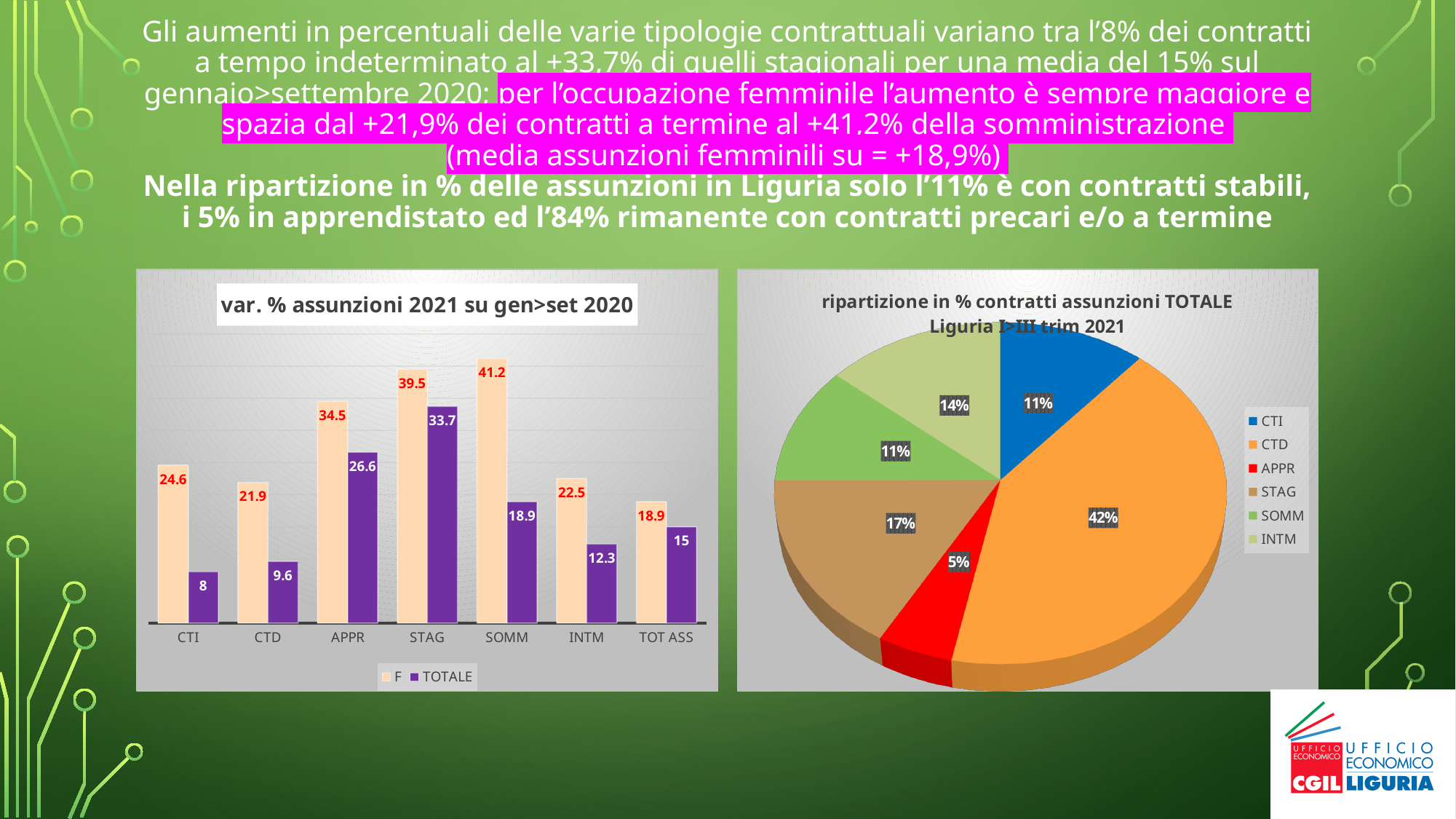
How many categories are shown on the x axis of the bar chart 'var. % assunzioni 2021 su gen>set 2020'? 7 In the bar chart 'var. % assunzioni 2021 su gen>set 2020', which category has the highest F value? SOMM In the bar chart 'var. % assunzioni 2021 su gen>set 2020', what is the F value for SOMM? 41.2 In the bar chart 'var. % assunzioni 2021 su gen>set 2020', what is the difference between the F and TOTALE values for CTI? 16.6 In the bar chart 'var. % assunzioni 2021 su gen>set 2020', is the TOTALE value for APPR larger or smaller than the TOTALE value for INTM? larger In the pie chart 'ripartizione in % contratti assunzioni TOTALE Liguria I>III trim 2021', what share does CTD have? 42% In the bar chart 'var. % assunzioni 2021 su gen>set 2020', what is the TOTALE value for STAG? 33.7 What kind of chart is the chart on the right of the slide? Pie chart In the pie chart 'ripartizione in % contratti assunzioni TOTALE Liguria I>III trim 2021', what is the difference between the STAG share and the INTM share? 3% In the pie chart 'ripartizione in % contratti assunzioni TOTALE Liguria I>III trim 2021', which category has the smallest slice? APPR How many series does the legend of the bar chart 'var. % assunzioni 2021 su gen>set 2020' list? 2 In the bar chart 'var. % assunzioni 2021 su gen>set 2020', which category has the lowest TOTALE value? CTI